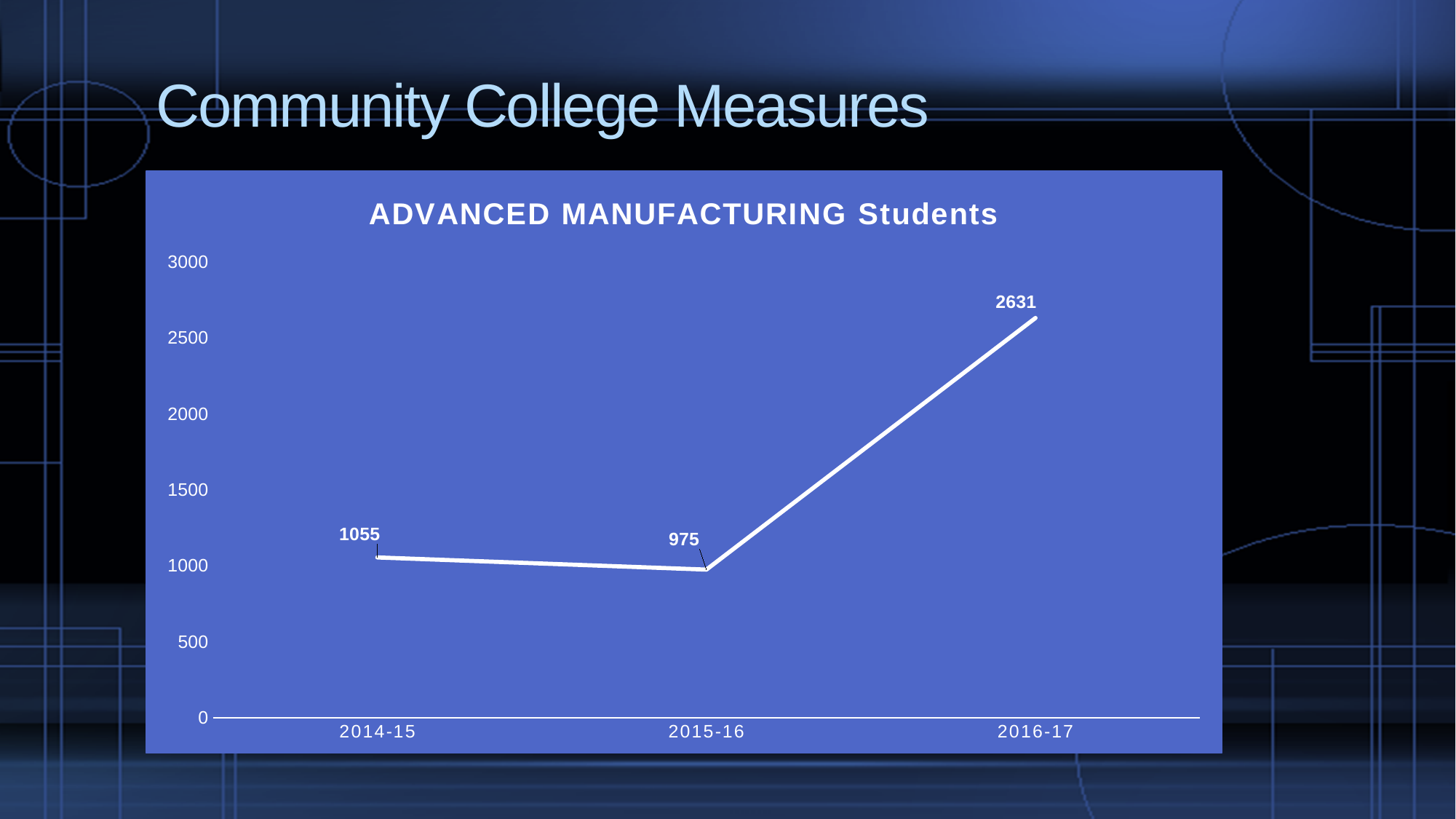
What is the value for 2014-15? 1055 What is the difference between the values for 2014-15 and 2015-16? 80 How many years are plotted on the chart? 3 What is the difference between the values for 2016-17 and 2015-16? 1656 What is the value for 2015-16? 975 Is the value for 2016-17 greater or less than 2500? greater Which year has the highest number of Advanced Manufacturing students? 2016-17 What is the title of the chart? ADVANCED MANUFACTURING Students What kind of chart is shown on the slide? line chart Which year has the lowest number of Advanced Manufacturing students? 2015-16 What is the value for 2016-17? 2631 Which is larger, the value for 2014-15 or the value for 2015-16? 2014-15